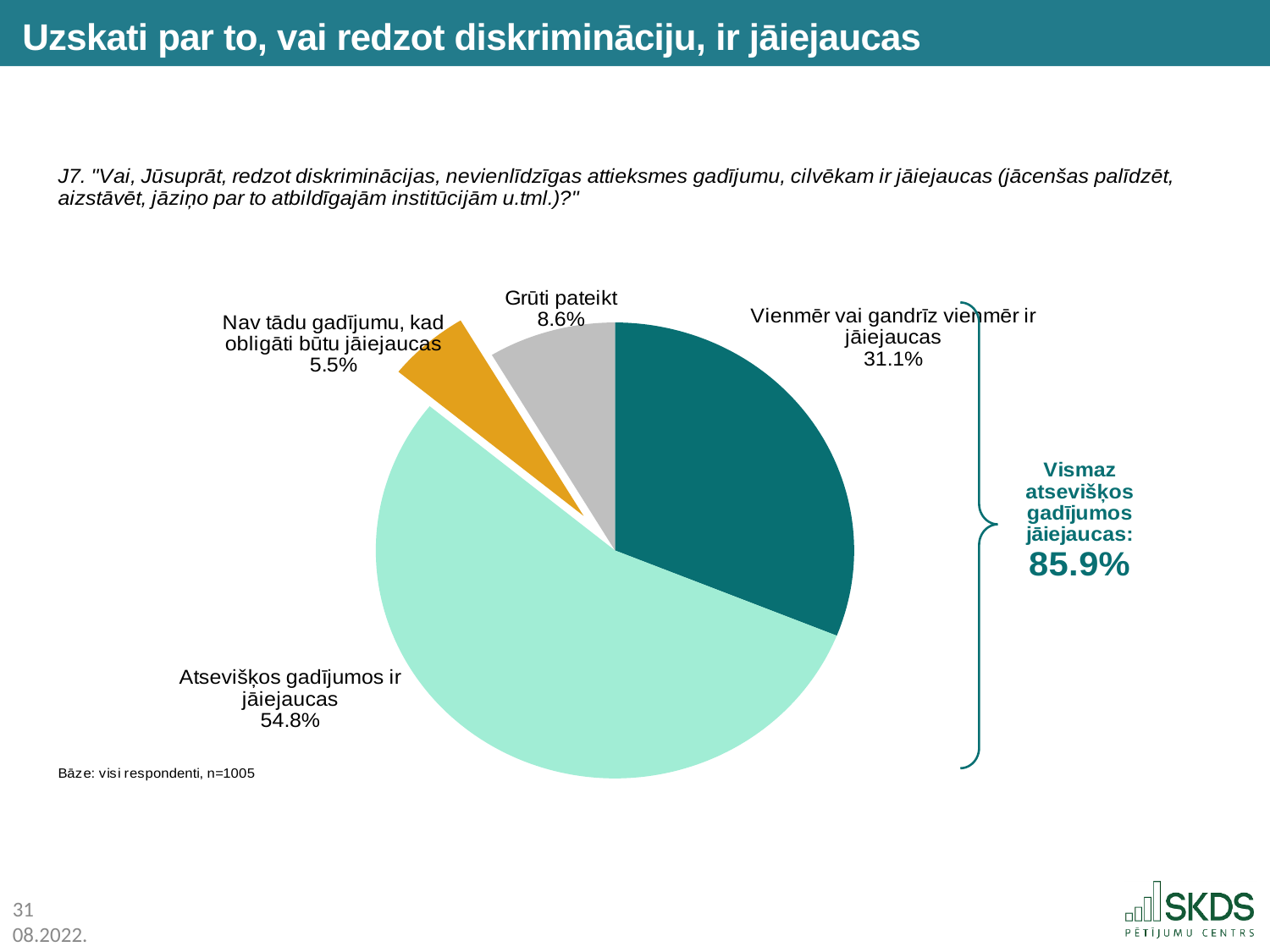
Which answer category has the smallest slice of the pie? Nav tādu gadījumu, kad obligāti būtu jāiejaucas Which is larger: the share for "Grūti pateikt" or the share for "Nav tādu gadījumu, kad obligāti būtu jāiejaucas"? Grūti pateikt What share of respondents answered "Atsevišķos gadījumos ir jāiejaucas"? 54.8% What combined percentage is shown next to the bracket labelled "Vismaz atsevišķos gadījumos jāiejaucas"? 85.9% What share of respondents answered "Vienmēr vai gandrīz vienmēr ir jāiejaucas"? 31.1% What share of respondents answered "Nav tādu gadījumu, kad obligāti būtu jāiejaucas"? 5.5% What is the difference in percentage points between "Atsevišķos gadījumos ir jāiejaucas" and "Vienmēr vai gandrīz vienmēr ir jāiejaucas"? 23.7 What share of respondents answered "Grūti pateikt"? 8.6% Which answer category has the largest slice of the pie? Atsevišķos gadījumos ir jāiejaucas What is the base (number of respondents) stated below the chart? n=1005 What kind of chart is shown on the slide? pie chart How many slices does the pie chart have? 4